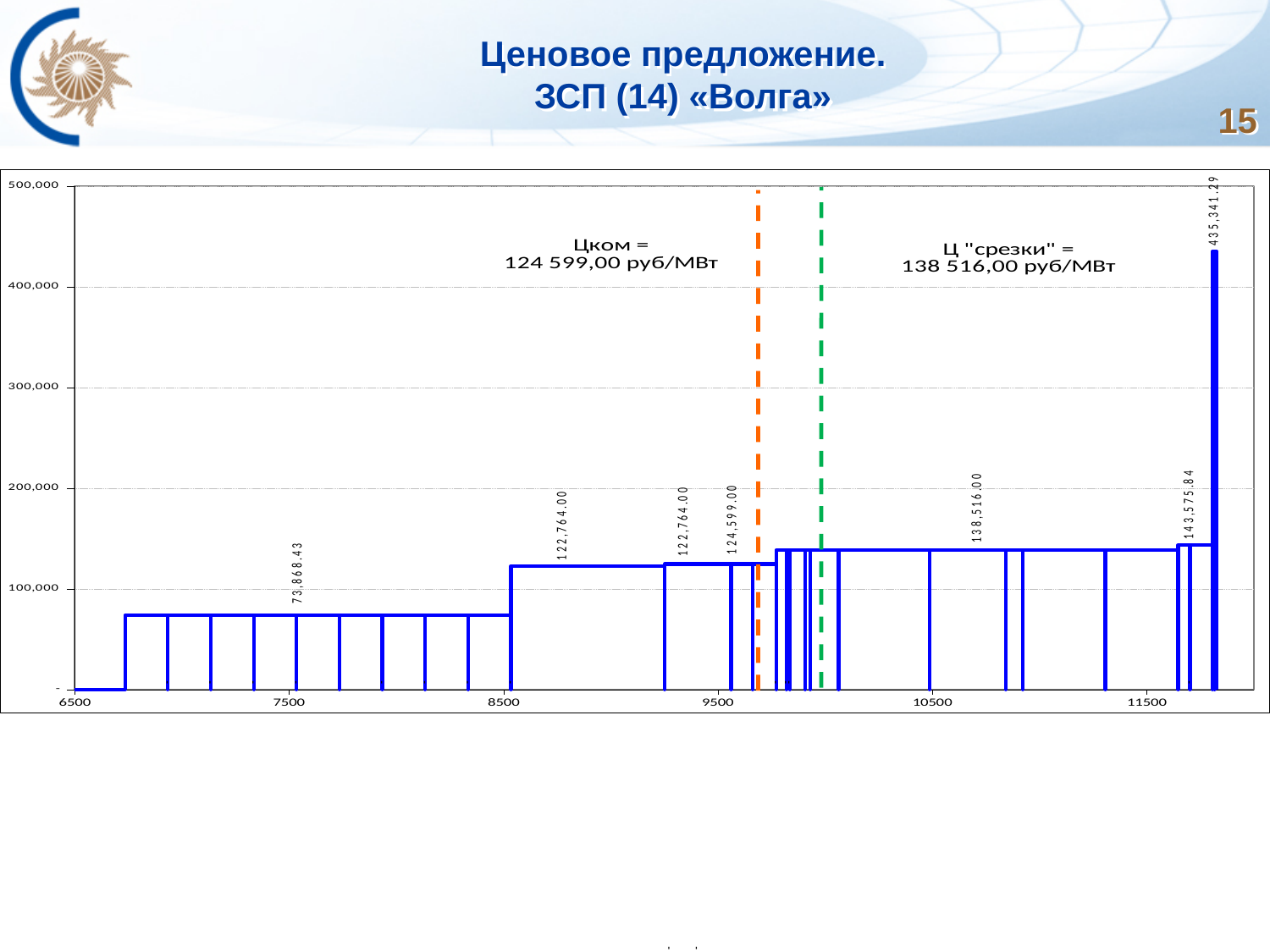
What value is labelled on the step of the curve between roughly 8500 and 9000 on the x axis? 122,764.00 Is the value of the curve at x = 7500 greater or less than 100,000? less What value is labelled on the long step of the curve between roughly 10000 and 11500 on the x axis? 138,516.00 What value of Ц "срезки" is stated in the annotation on the chart? 138 516,00 руб/МВт Which labelled value is larger: 124,599.00 or 122,764.00? 124,599.00 Do the values of the curve generally rise or fall as the x axis increases? rise What is the difference between the labelled values 143,575.84 and 138,516.00? 5,059.84 What is the lowest data label shown on the chart? 73,868.43 What is the highest data label shown on the chart? 435,341.29 What value of Цком is stated in the annotation on the chart? 124 599,00 руб/МВт Is the value of the curve at x = 10500 greater or less than 100,000? greater What is the difference between the labelled values 138,516.00 and 124,599.00? 13,917.00